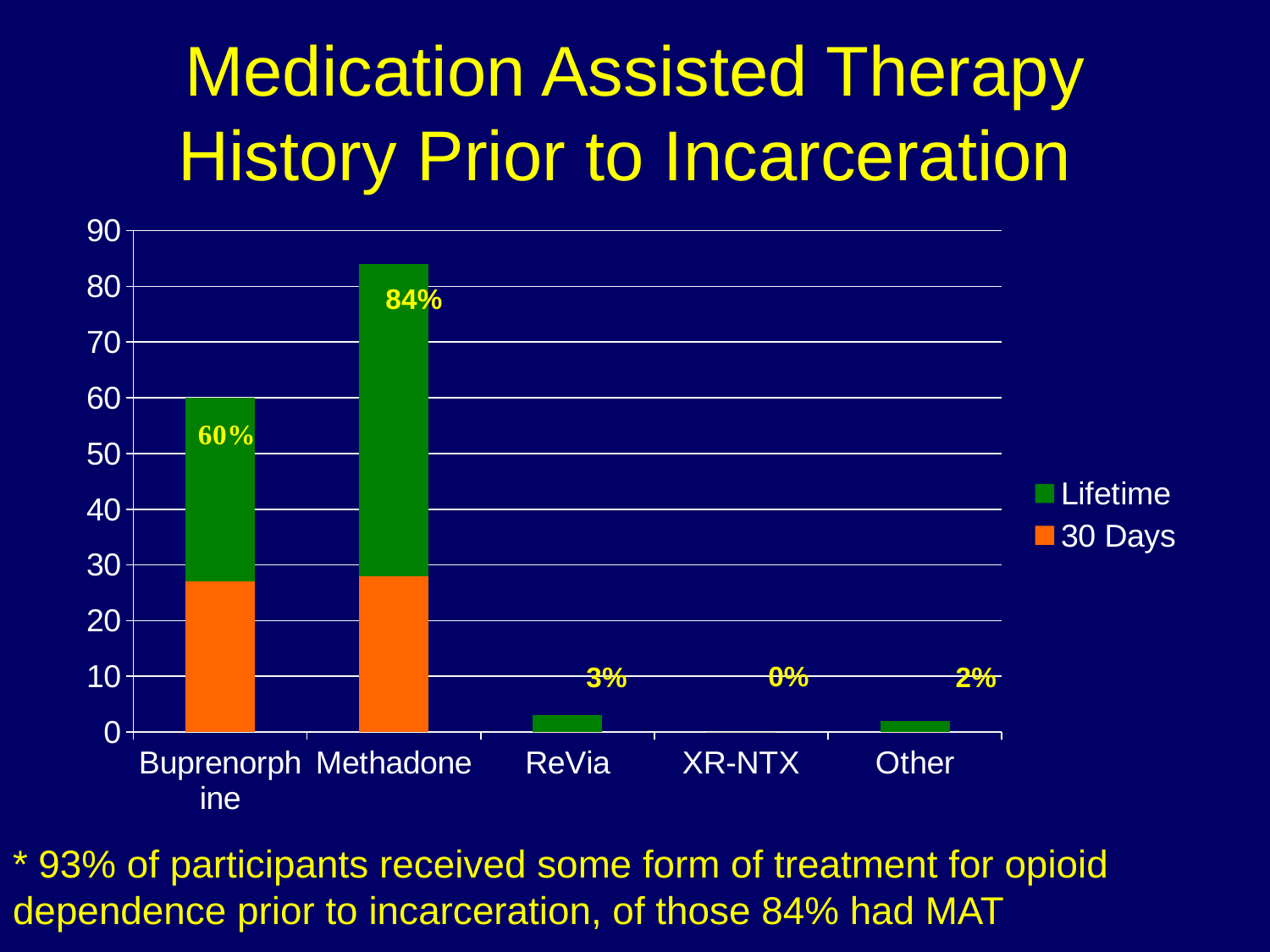
How many medication categories are shown on the x axis? 5 Which medication has the lowest labelled value? XR-NTX What percentage is labelled on the Buprenorphine bar? 60% How many series does the chart legend list? 2 What percentage is labelled for XR-NTX? 0% What percentage is labelled on the Methadone bar? 84% What kind of chart is shown on the slide? Stacked bar chart Which medication has the tallest bar? Methadone Which colour represents the 30 Days series in the legend? Orange What percentage is labelled for ReVia? 3% What percentage is labelled for Other? 2% Is the 30 Days value for Buprenorphine greater or less than 40? less